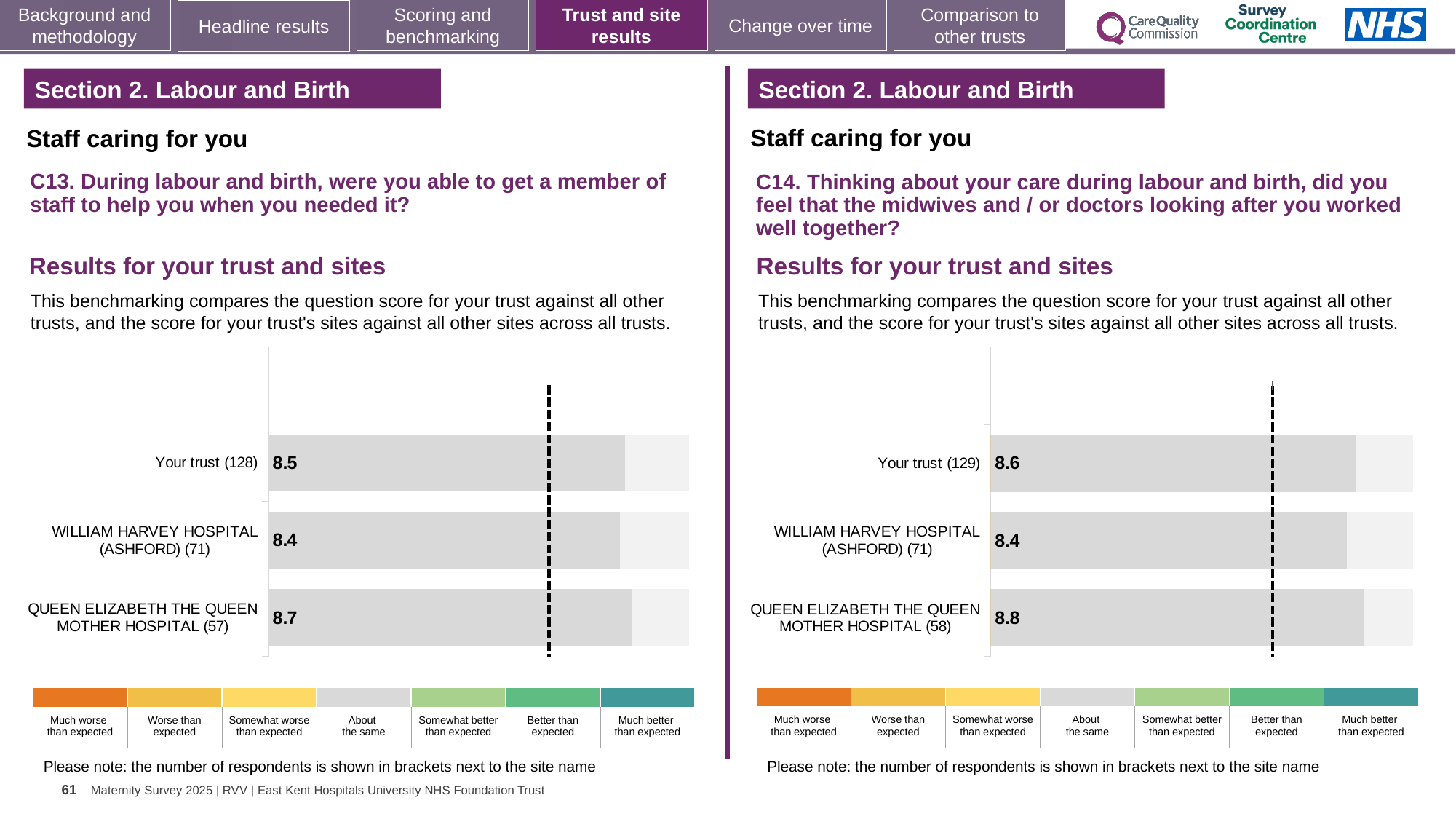
In the C14 chart on the right, what is the score for Your trust? 8.6 In the C14 chart on the right, which is larger: the score for Your trust or the score for WILLIAM HARVEY HOSPITAL (ASHFORD)? Your trust In the C14 chart on the right, how many respondents are shown in brackets for QUEEN ELIZABETH THE QUEEN MOTHER HOSPITAL? 58 In the C13 chart on the left, what is the score for QUEEN ELIZABETH THE QUEEN MOTHER HOSPITAL? 8.7 In the C14 chart on the right, which site or trust has the highest score? QUEEN ELIZABETH THE QUEEN MOTHER HOSPITAL What kind of chart is used in the C13 chart on the left? Bar chart In the C13 chart on the left, which site or trust has the lowest score? WILLIAM HARVEY HOSPITAL (ASHFORD) In the C13 chart on the left, how many bars are plotted? 3 In the C14 chart on the right, what is the score for WILLIAM HARVEY HOSPITAL (ASHFORD)? 8.4 In the C14 chart on the right, what is the difference between the scores for QUEEN ELIZABETH THE QUEEN MOTHER HOSPITAL and Your trust? 0.2 In the C13 chart on the left, what is the difference between the scores for QUEEN ELIZABETH THE QUEEN MOTHER HOSPITAL and WILLIAM HARVEY HOSPITAL (ASHFORD)? 0.3 In the C13 chart on the left, what is the score for Your trust? 8.5